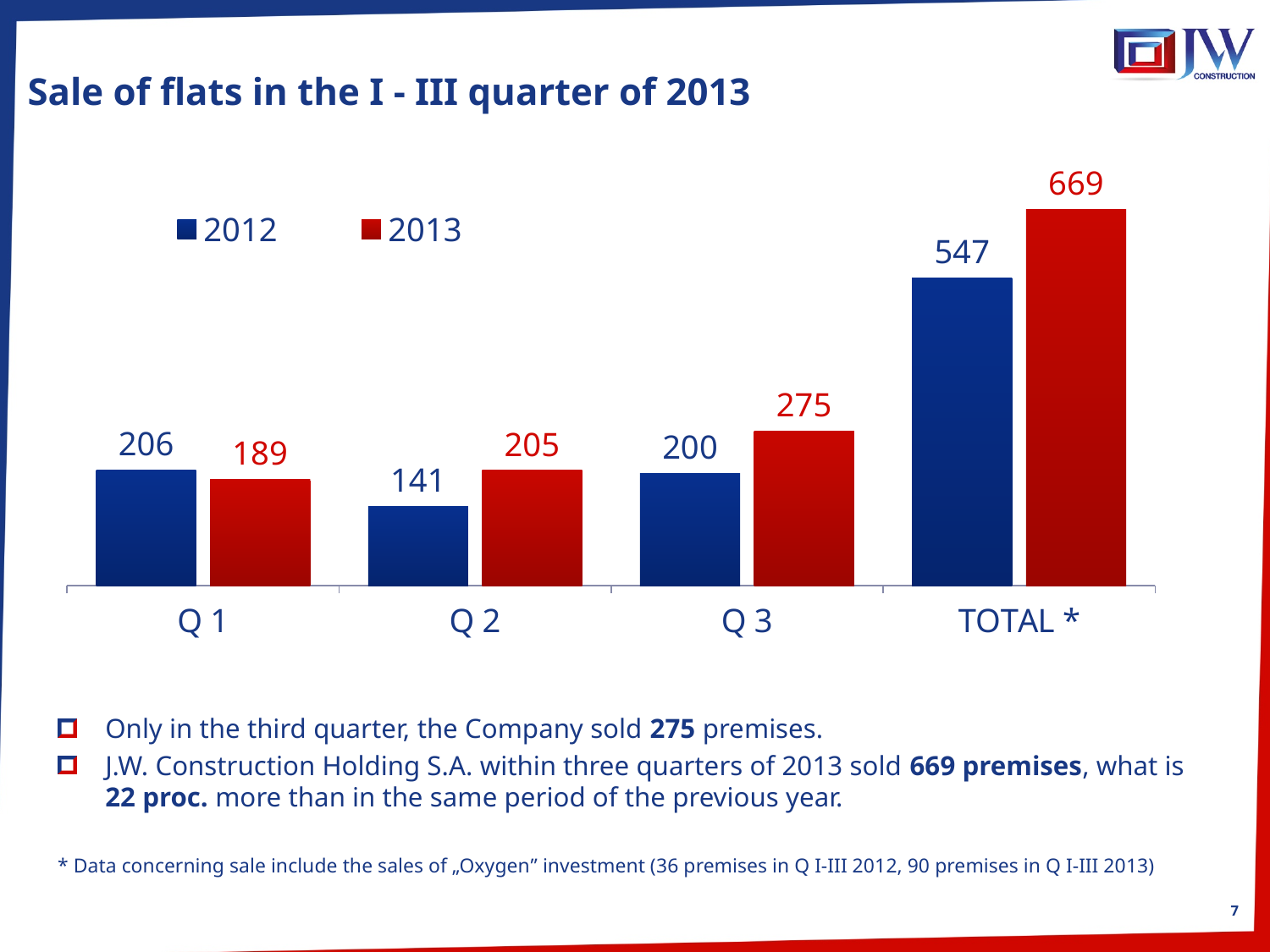
How many categories are shown on the x axis? 4 What is the difference between the 2013 and 2012 values in TOTAL *? 122 What kind of chart is shown on the slide? Bar chart Which category has the lowest value for the 2012 series? Q 2 How many series does the legend list? 2 What is the value for 2013 in Q 1? 189 In Q 1, which series has the larger value, 2012 or 2013? 2012 Which category has the highest value for the 2013 series? TOTAL * What is the value for 2012 in TOTAL *? 547 What is the difference between the 2013 and 2012 values in Q 2? 64 What is the value for 2013 in Q 3? 275 What is the value for 2012 in Q 2? 141